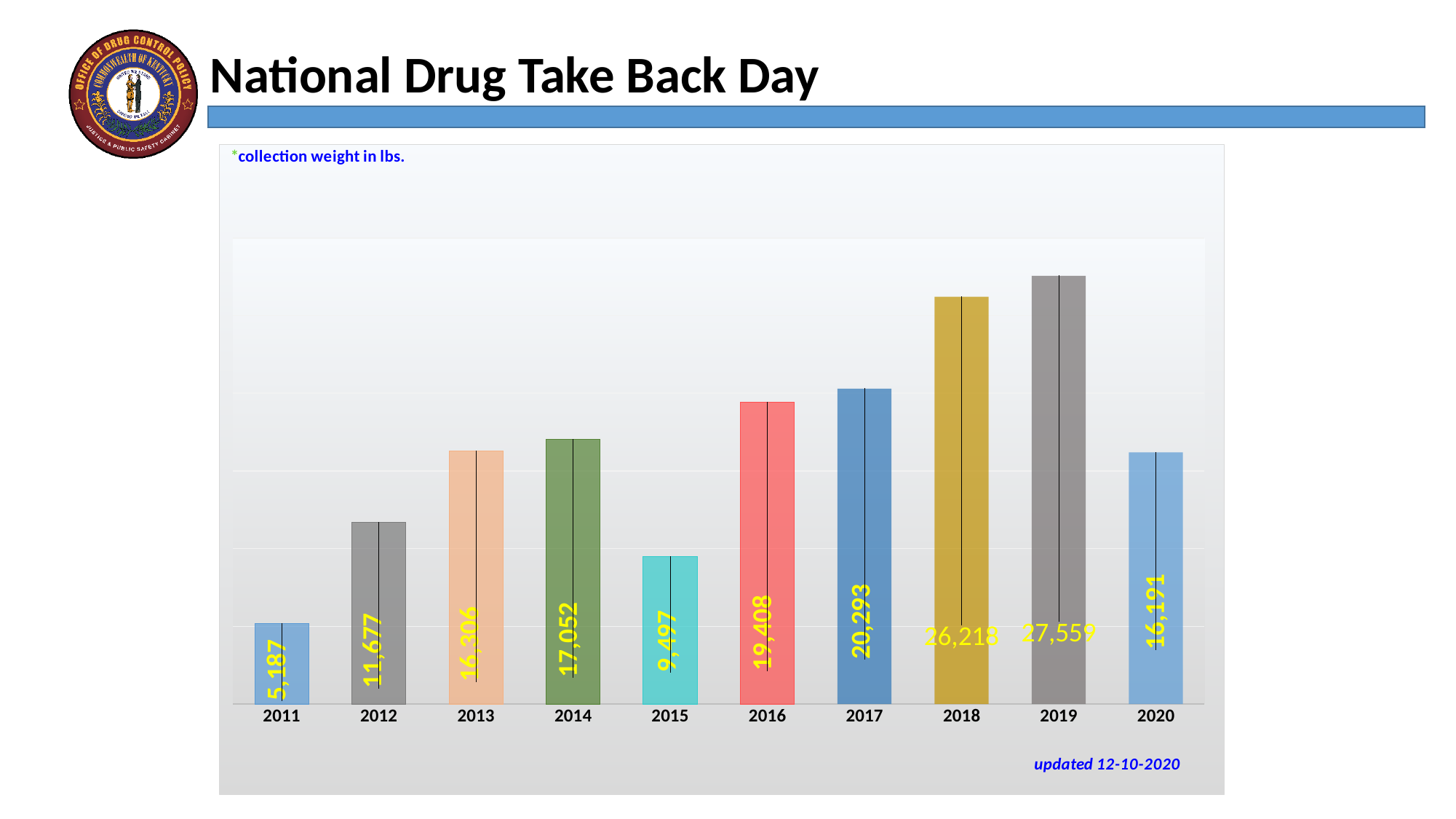
Which year had the lowest collection weight? 2011 What is the difference in collection weight between 2017 and 2016? 885 What was the collection weight in 2011? 5,187 What was the collection weight in 2018? 26,218 What was the collection weight in 2020? 16,191 Which year had the highest collection weight? 2019 What unit are the collection weights measured in, according to the note on the chart? lbs. How many years are shown on the chart? 10 What kind of chart is shown on the slide? Bar chart What is the difference in collection weight between 2019 and 2018? 1,341 Which year had a larger collection weight, 2015 or 2012? 2012 Which year had a larger collection weight, 2013 or 2020? 2013